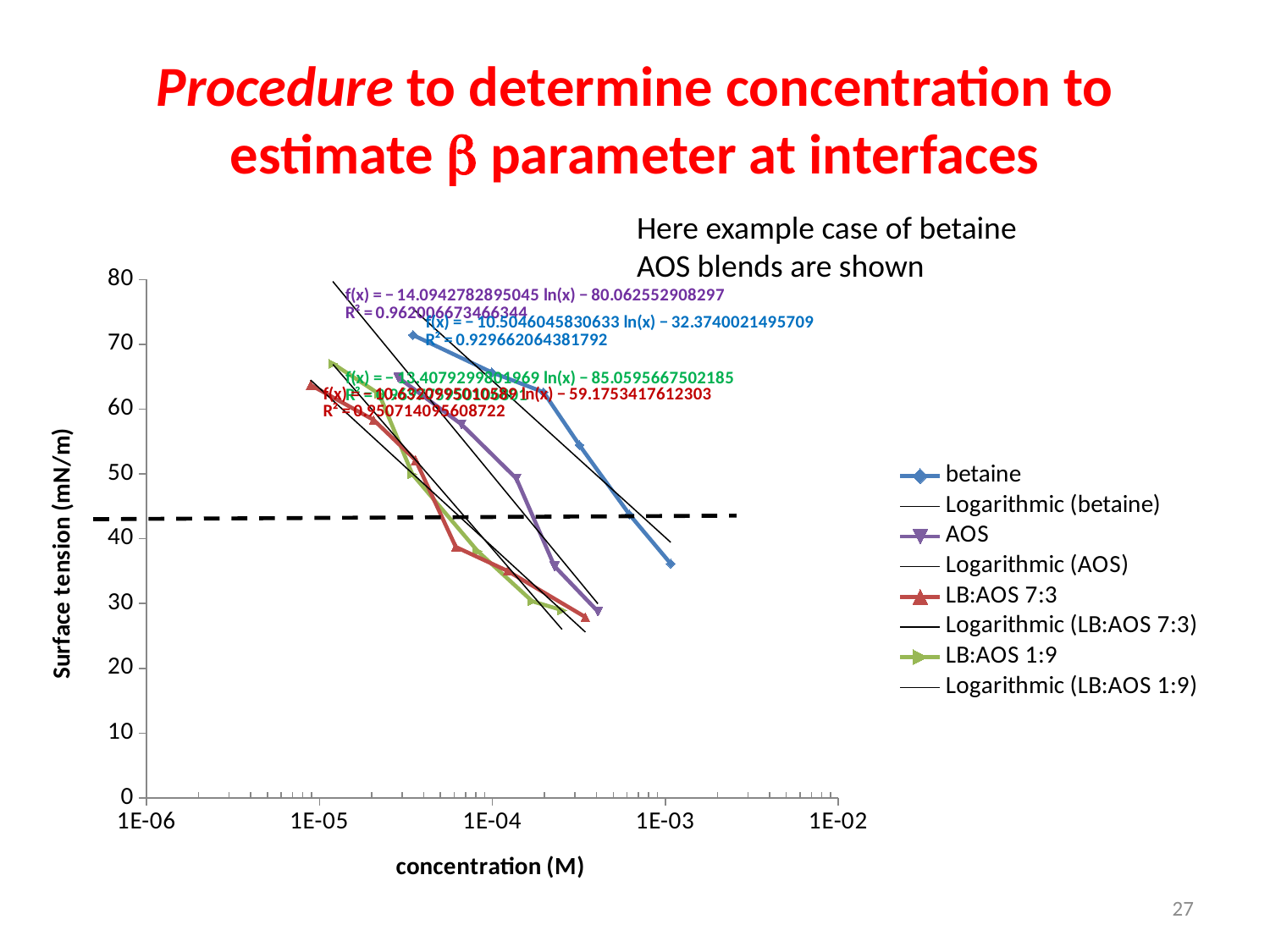
Is the surface tension of the last (highest-concentration) betaine point greater or less than 40 mN/m? less As concentration increases along the x axis, does the surface tension for betaine rise or fall? fall Which series has the highest surface tension value at its first data point? betaine What is the title of the y axis of the chart? Surface tension (mN/m) What is the R² value printed for the logarithmic trendline of betaine? 0.929662064381792 Is the surface tension of the first (lowest-concentration) AOS point greater or less than 60 mN/m? greater How many entries does the chart legend list? 8 What is the coefficient of ln(x) in the printed trendline equation for betaine? −10.5046045830633 What kind of chart is shown on the slide? line chart What is the title of the x axis of the chart? concentration (M) Is the surface tension of the first (lowest-concentration) LB:AOS 1:9 point greater or less than 60 mN/m? greater Which series extends to the highest concentration on the x axis? betaine